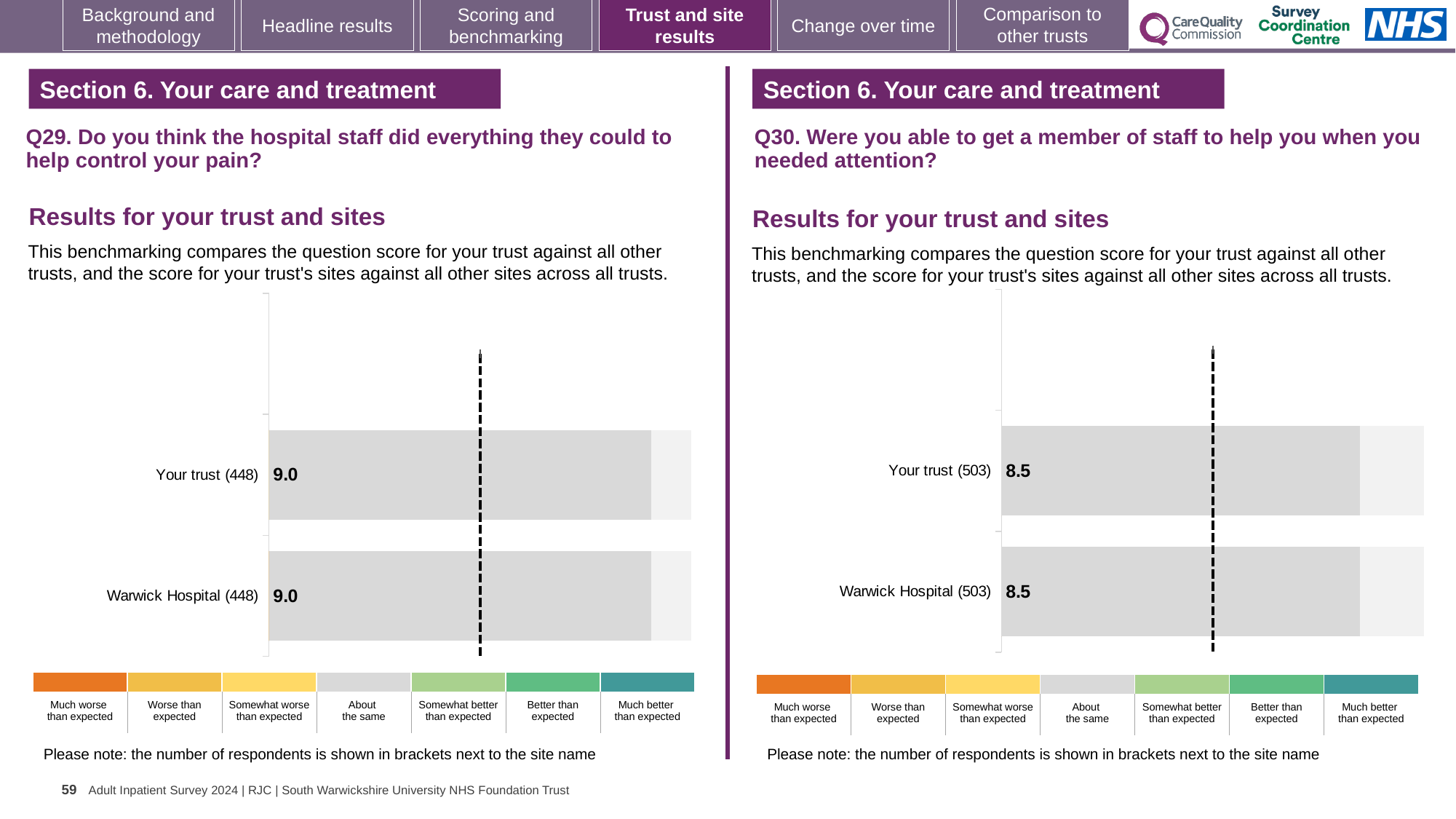
Which is larger: the Your trust score on the Q29 chart (left) or the Your trust score on the Q30 chart (right)? Q29 chart (left) On the Q30 chart (right), what is the score for Warwick Hospital (503)? 8.5 On the Q29 chart (left), how many respondents are shown in brackets next to Your trust? 448 How many bars are plotted on the Q29 chart (left)? 2 What kind of chart is used on the Q29 chart (left)? Bar chart How many bars are plotted on the Q30 chart (right)? 2 How many benchmark categories does the colour key below the Q29 chart (left) list? 7 On the Q29 chart (left), what is the score for Your trust (448)? 9.0 What is the difference between the Your trust score on the Q29 chart (left) and the Your trust score on the Q30 chart (right)? 0.5 On the Q30 chart (right), how many respondents are shown in brackets next to Warwick Hospital? 503 On the Q29 chart (left), what is the score for Warwick Hospital (448)? 9.0 On the Q30 chart (right), what is the score for Your trust (503)? 8.5